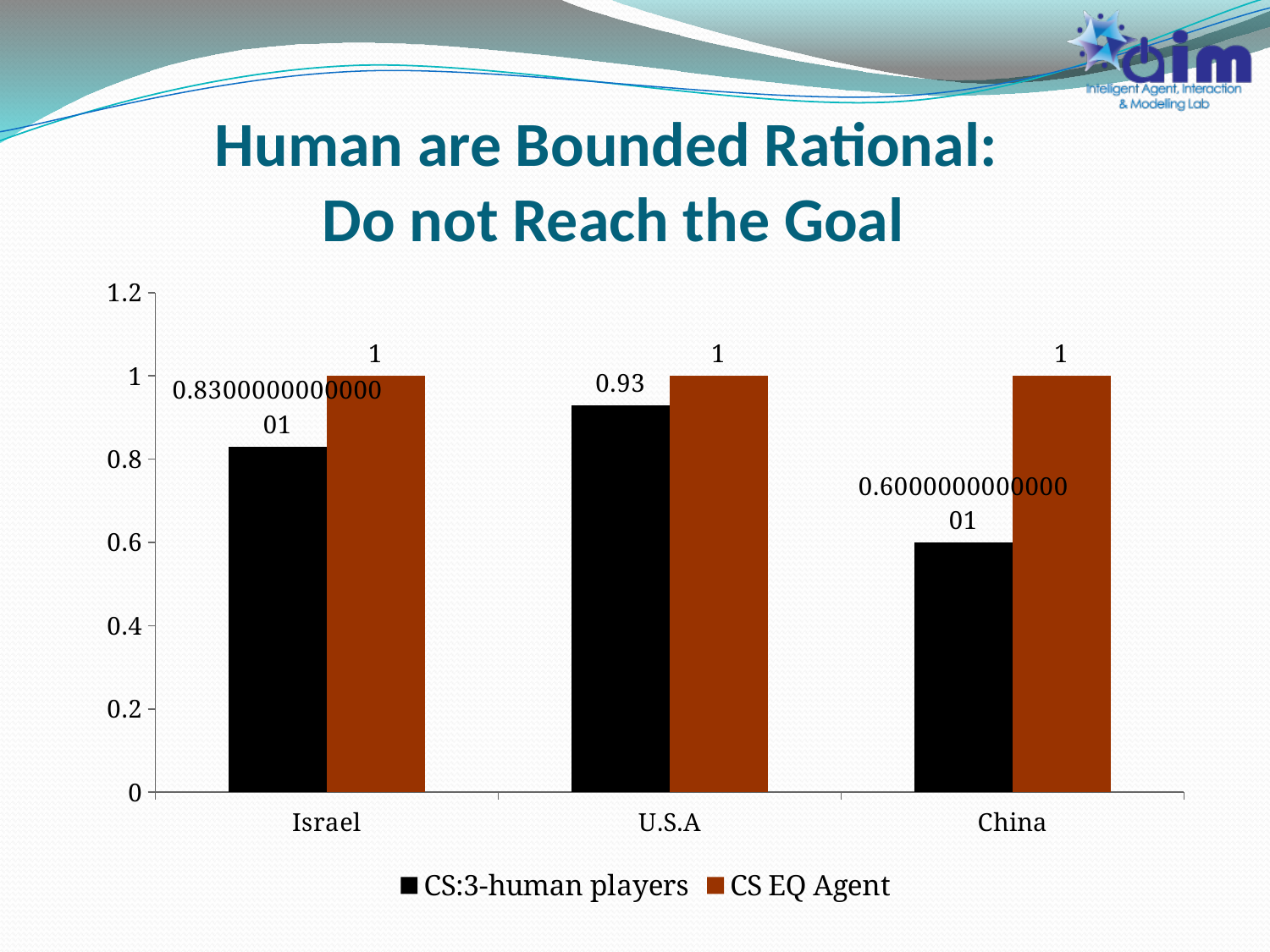
What is the difference between CS EQ Agent and CS:3-human players in U.S.A? 0.07 What kind of chart is shown on the slide? bar chart Is the value for CS:3-human players in China greater or less than 0.8? less Which country has the lowest value for CS:3-human players? China Which is larger for CS:3-human players, Israel or U.S.A? U.S.A What is the value for CS EQ Agent in Israel? 1 Is the value for CS:3-human players in Israel greater or less than 0.8? greater What is the value for CS:3-human players in U.S.A? 0.93 How many countries are shown on the x axis? 3 How many series does the legend list? 2 Which country has the highest value for CS:3-human players? U.S.A What is the value for CS EQ Agent in China? 1